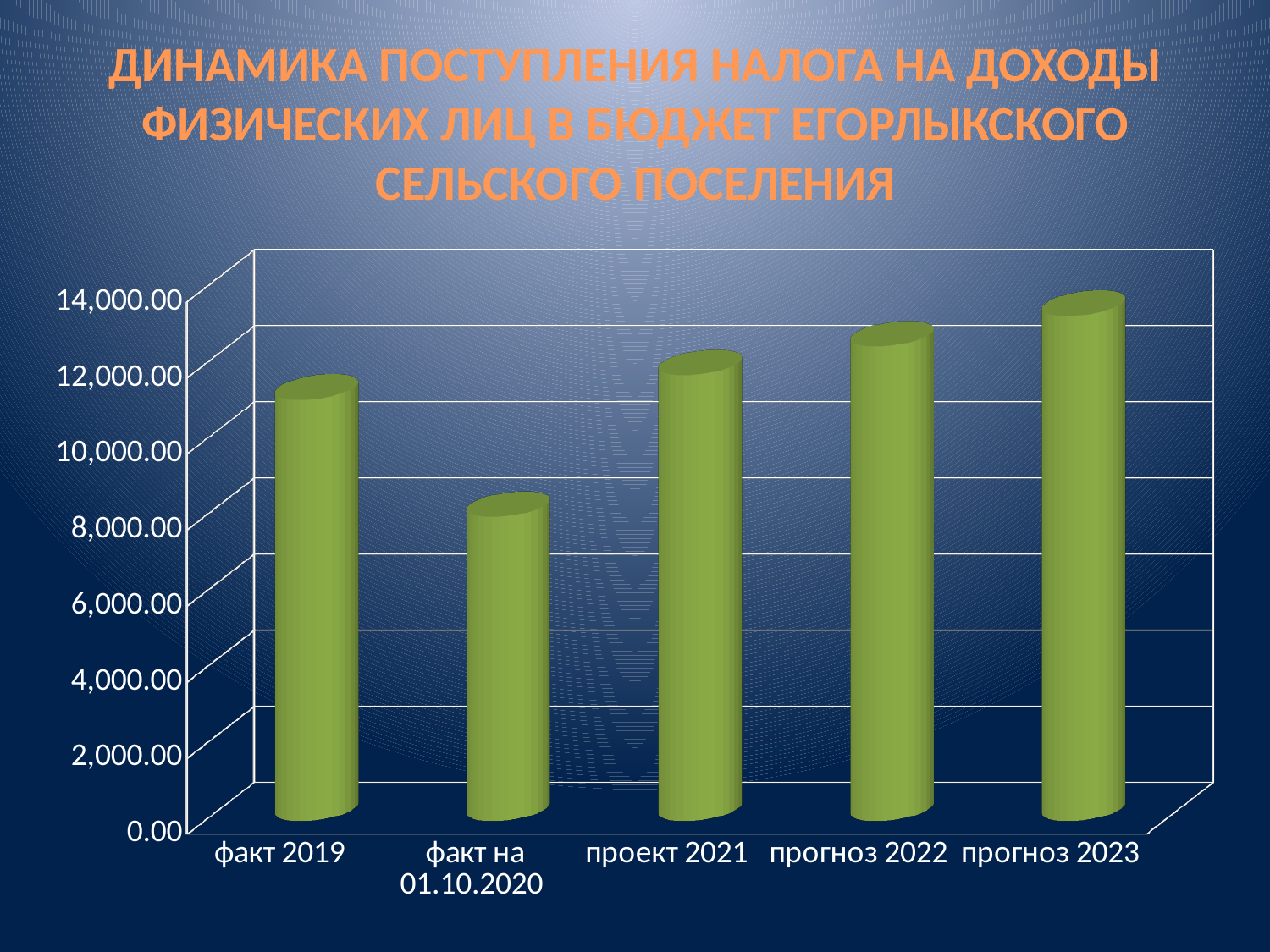
Is the value for прогноз 2023 greater or less than 14,000.00? less Is the value for прогноз 2022 greater or less than 12,000.00? greater What colour are the bars in the chart? green Which is larger, the value for прогноз 2022 or the value for факт 2019? прогноз 2022 How many categories are plotted on the x axis? 5 Do the values rise or fall from проект 2021 to прогноз 2023? rise Which category has the lowest value? факт на 01.10.2020 Is the value for факт на 01.10.2020 greater or less than 10,000.00? less Which category has the highest value? прогноз 2023 What kind of chart is shown on the slide? bar chart